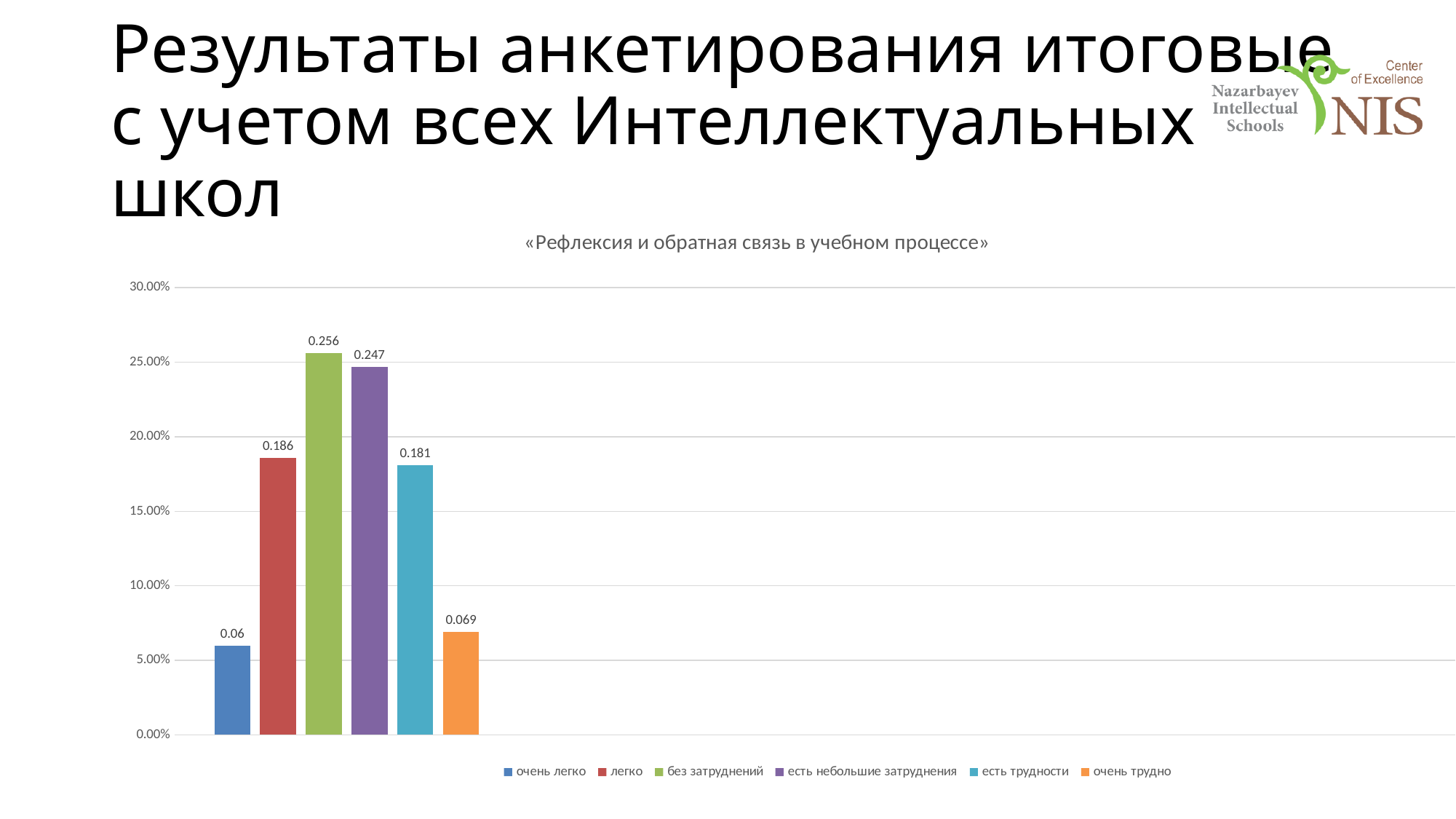
Which legend entry has the highest bar? без затруднений What is the data label on the bar for «очень легко»? 0.06 Which is larger, the bar for «легко» or the bar for «есть трудности»? легко Which legend entry has the lowest bar? очень легко What is the data label on the bar for «очень трудно»? 0.069 What is the title of the chart? «Рефлексия и обратная связь в учебном процессе» What is the data label on the bar for «без затруднений»? 0.256 How many entries does the legend list? 6 What kind of chart is shown on the slide? bar chart What is the data label on the bar for «есть трудности»? 0.181 What is the difference between the data labels for «без затруднений» and «очень легко»? 0.196 Is the bar for «есть небольшие затруднения» greater or less than 20.00%? greater